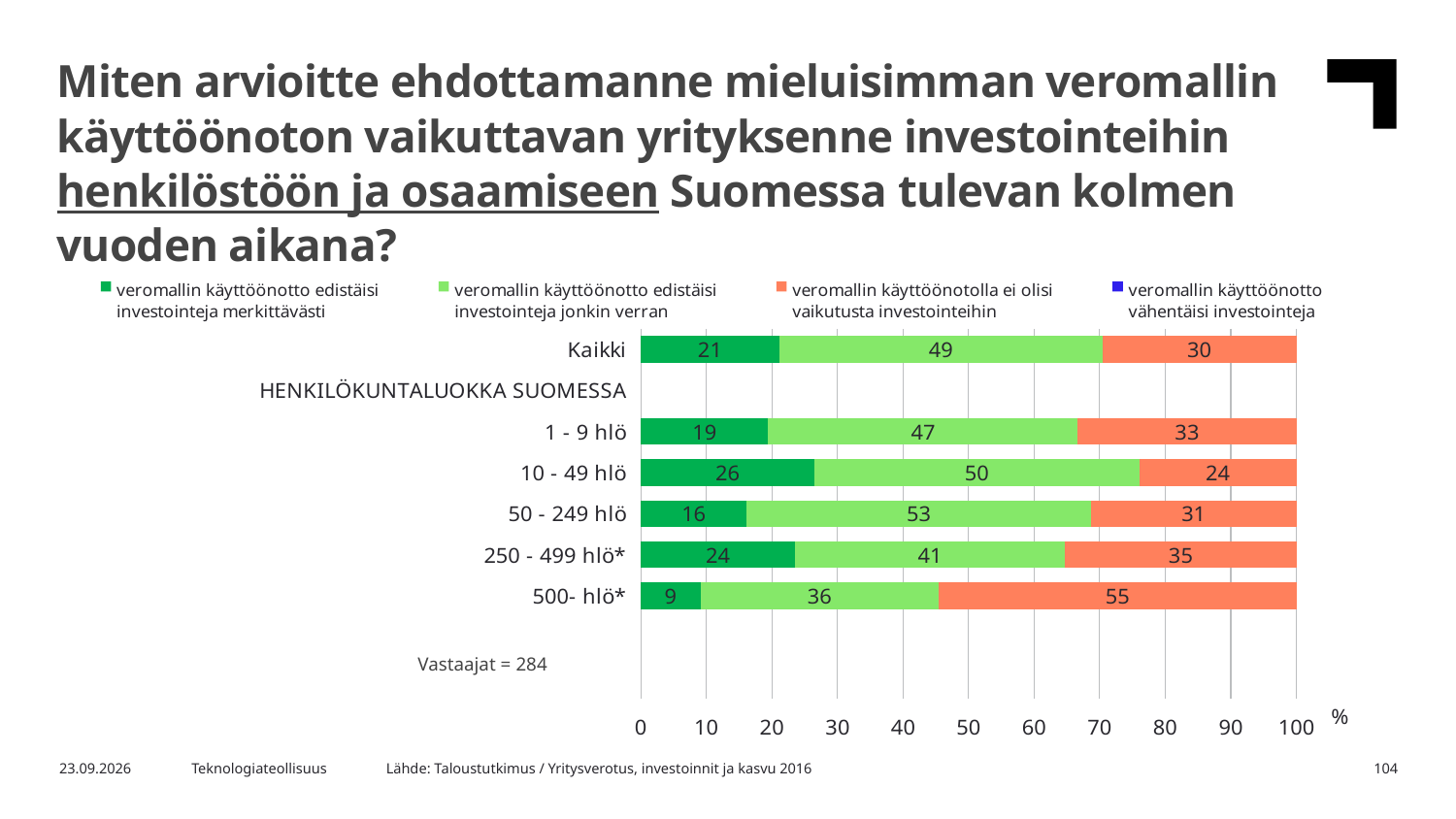
How many category bars are plotted in the chart? 6 What is the total of the 250 - 499 hlö* stacked bar? 100 What kind of chart is shown on the slide? Stacked bar chart What is the value for 'veromallin käyttöönotto edistäisi investointeja jonkin verran' in the 50 - 249 hlö bar? 53 What is the value for 'veromallin käyttöönotto edistäisi investointeja merkittävästi' in the Kaikki bar? 21 How many respondents (Vastaajat) are stated on the slide? 284 How many series does the legend list? 4 Which category has the lowest value for 'veromallin käyttöönotto edistäisi investointeja merkittävästi'? 500- hlö* Which category has the highest value for 'veromallin käyttöönotto edistäisi investointeja merkittävästi'? 10 - 49 hlö What is the value for 'veromallin käyttöönotolla ei olisi vaikutusta investointeihin' in the 500- hlö* bar? 55 Which is larger: the 'veromallin käyttöönotto edistäisi investointeja jonkin verran' value for 1 - 9 hlö or for 250 - 499 hlö*? 1 - 9 hlö What is the difference between the 'veromallin käyttöönotolla ei olisi vaikutusta investointeihin' values for 500- hlö* and 10 - 49 hlö? 31